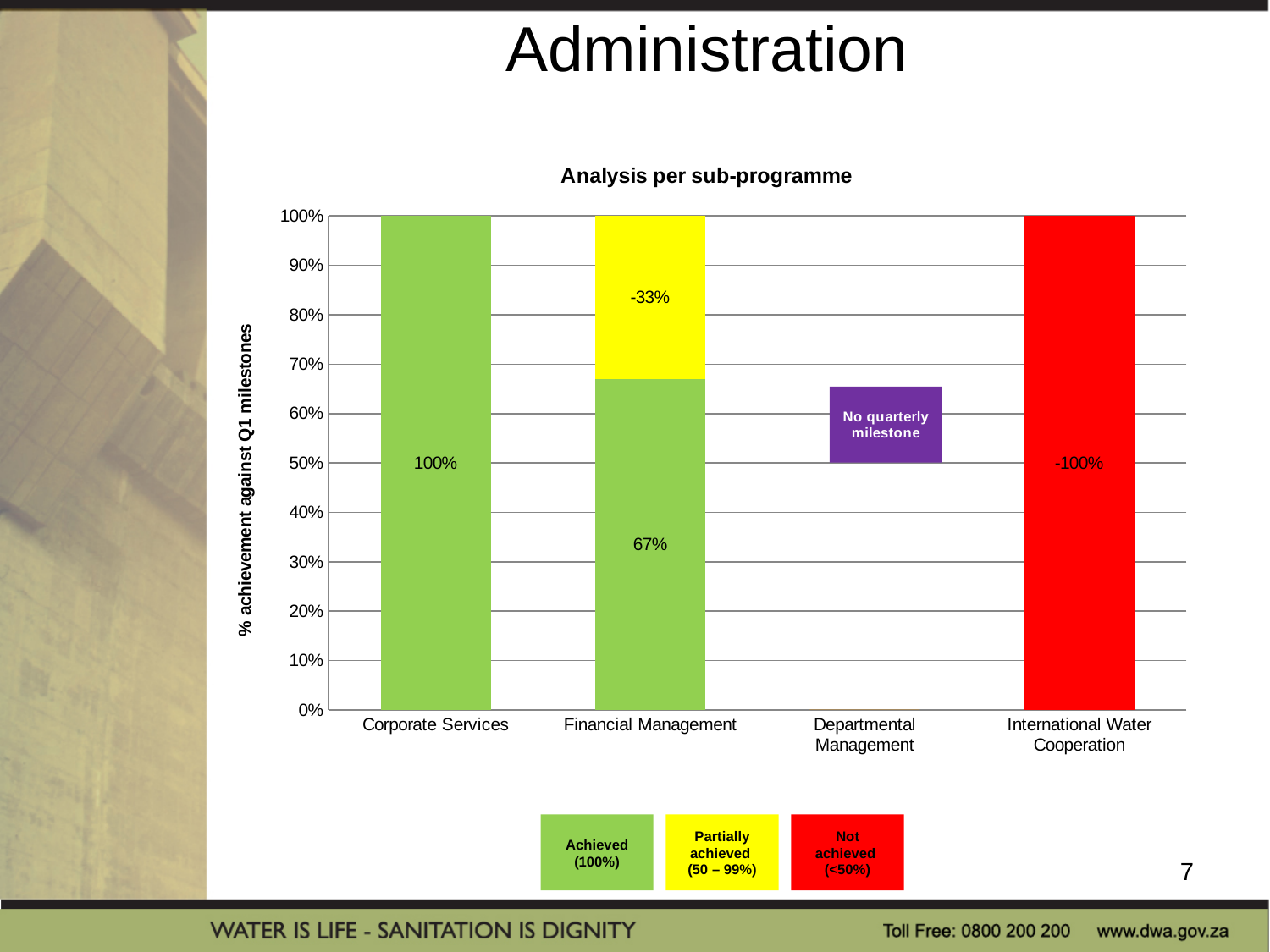
Is the green (achieved) segment for Financial Management greater or less than 50%? greater What value is labelled on the yellow segment of the Financial Management bar? -33% Which sub-programme has the green (achieved) segment reaching 100%? Corporate Services What is the label of the y axis? % achievement against Q1 milestones What value is labelled on the green segment of the Financial Management bar? 67% How many sub-programme categories are shown on the x axis? 4 What value is labelled on the green bar for Corporate Services? 100% What type of chart is shown on the slide? bar chart Which colour represents 'Not achieved (<50%)' in the legend? red What text is shown in place of a bar for Departmental Management? No quarterly milestone What value is labelled on the red bar for International Water Cooperation? -100% What is the title of the chart? Analysis per sub-programme